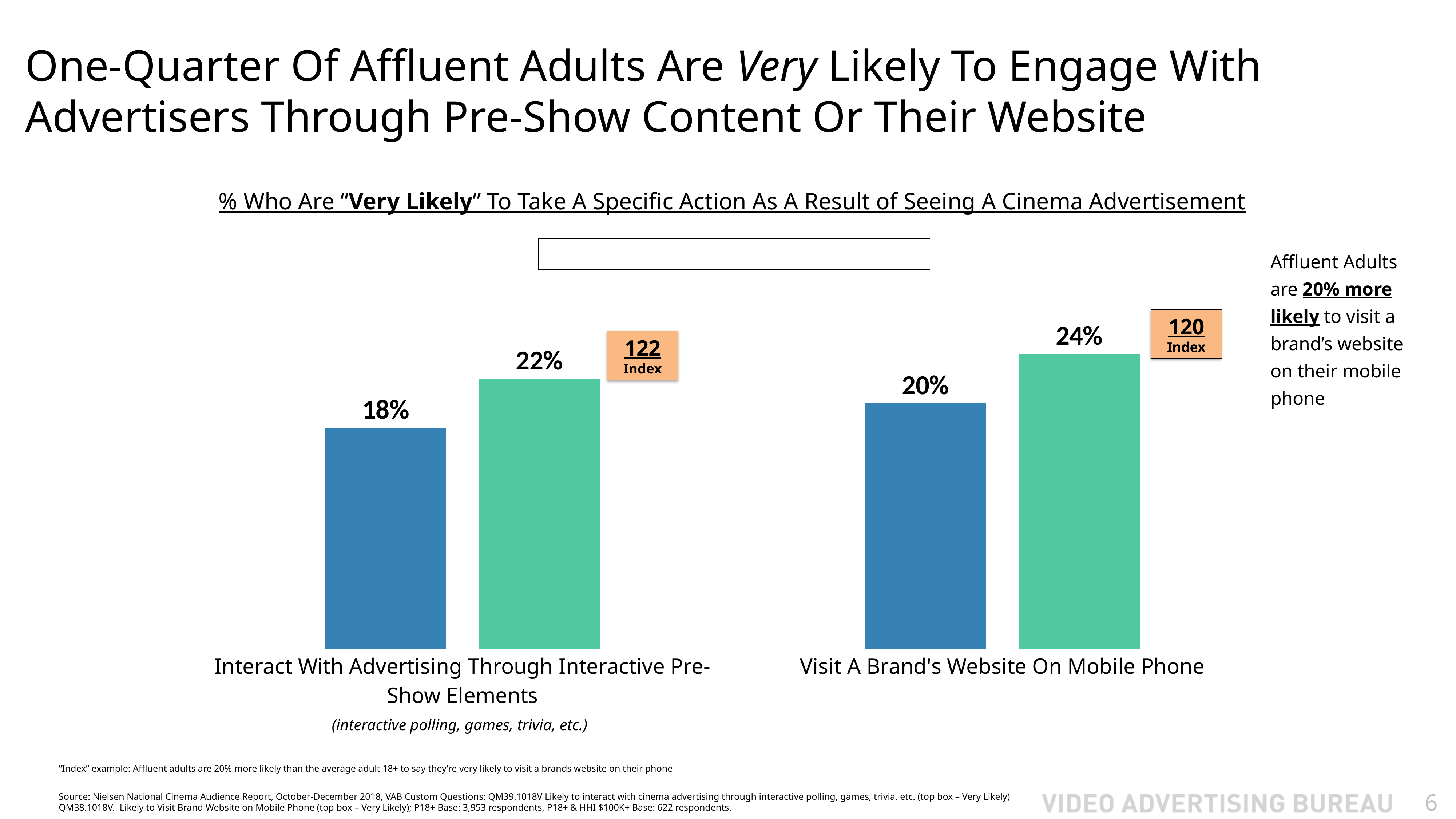
What is the value of the green bar for "Interact With Advertising Through Interactive Pre-Show Elements"? 22% What is the value of the blue bar for "Interact With Advertising Through Interactive Pre-Show Elements"? 18% What index value is shown next to the "Interact With Advertising Through Interactive Pre-Show Elements" bars? 122 What is the value of the blue bar for "Visit A Brand's Website On Mobile Phone"? 20% Which is larger: the blue bar for "Visit A Brand's Website On Mobile Phone" or the green bar for "Interact With Advertising Through Interactive Pre-Show Elements"? the green bar for Interact With Advertising Through Interactive Pre-Show Elements (22%) What is the value of the green bar for "Visit A Brand's Website On Mobile Phone"? 24% Which bar has the highest value on the chart? the green bar for Visit A Brand's Website On Mobile Phone (24%) What index value is shown next to the "Visit A Brand's Website On Mobile Phone" bars? 120 How many categories are shown on the x axis of the chart? 2 What kind of chart is shown on the slide? bar chart What is the difference between the green and blue bars for "Visit A Brand's Website On Mobile Phone"? 4% Which bar has the lowest value on the chart? the blue bar for Interact With Advertising Through Interactive Pre-Show Elements (18%)